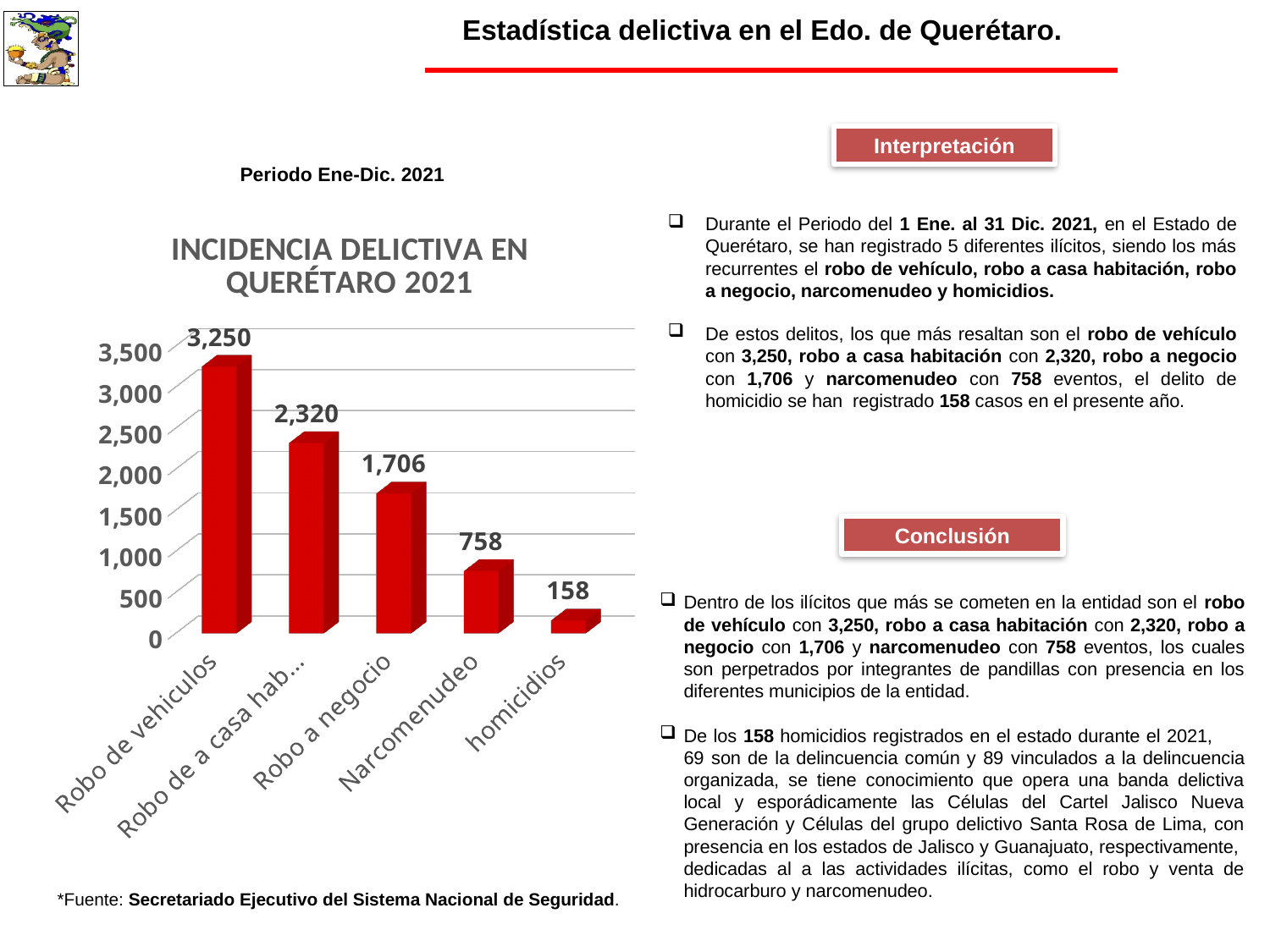
What kind of chart is shown on the slide? Bar chart Which category has the highest value in the chart? Robo de vehiculos Which is larger, the value for Robo a negocio or the value for Narcomenudeo? Robo a negocio What is the difference between the values for Robo de vehiculos and Robo a negocio? 1,544 What is the value for Robo de vehiculos in the chart? 3,250 What is the value for Narcomenudeo in the chart? 758 What is the title of the chart? INCIDENCIA DELICTIVA EN QUERÉTARO 2021 What is the value for homicidios in the chart? 158 What is the difference between the values for Narcomenudeo and homicidios? 600 Which category has the lowest value in the chart? homicidios What is the value for Robo a negocio in the chart? 1,706 How many categories are shown in the chart? 5